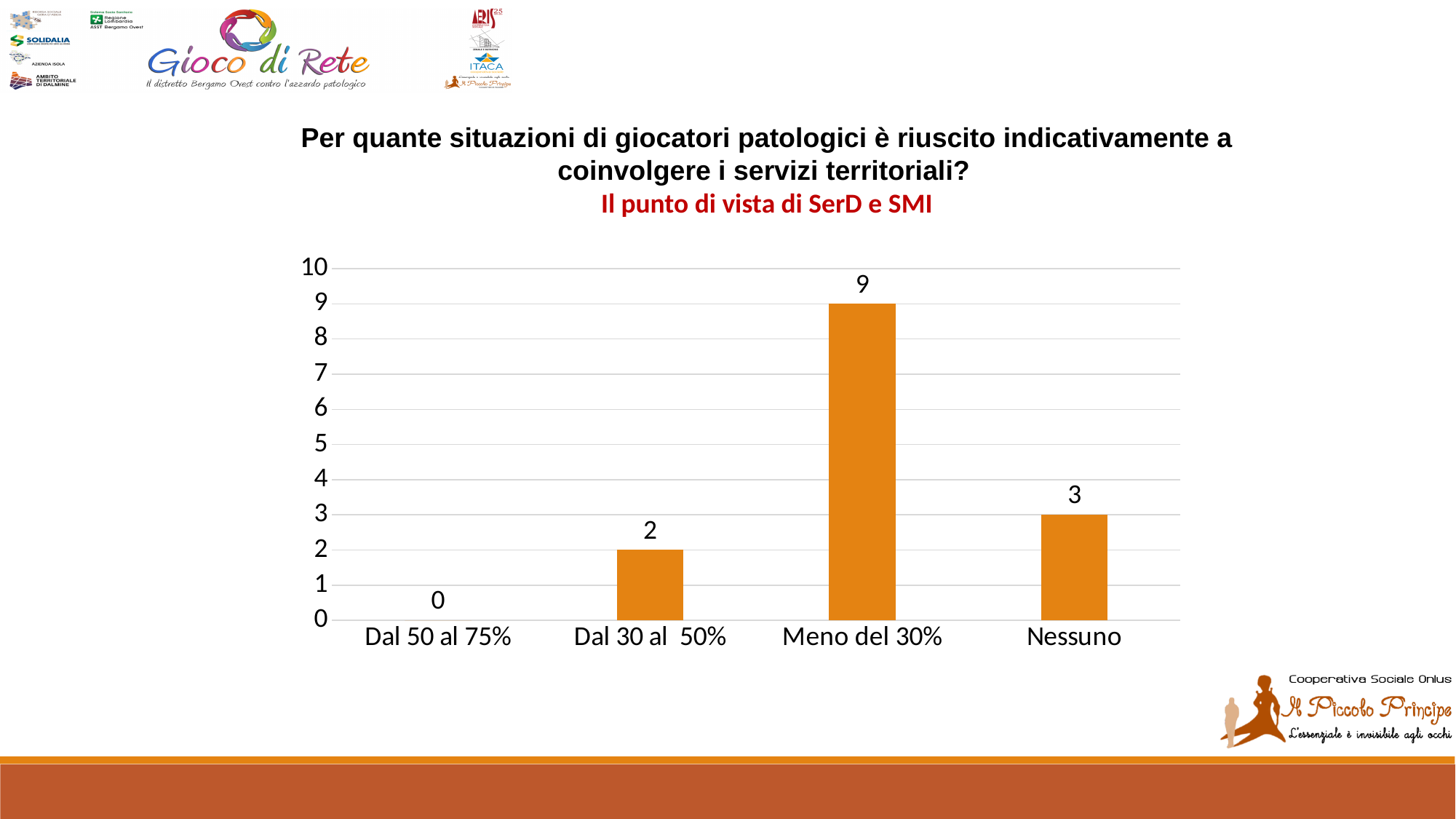
What is the value for 'Dal 30 al 50%'? 2 Which category has the lowest value? Dal 50 al 75% What is the value for 'Dal 50 al 75%'? 0 Is the value for 'Meno del 30%' greater or less than 5? greater Which is larger, the value for 'Nessuno' or the value for 'Dal 30 al 50%'? Nessuno What is the value for 'Meno del 30%'? 9 Which category has the highest value? Meno del 30% What kind of chart is shown on the slide? bar chart What is the difference between the values for 'Meno del 30%' and 'Nessuno'? 6 What is the red subtitle above the chart? Il punto di vista di SerD e SMI What is the value for 'Nessuno'? 3 How many categories are shown on the x axis? 4